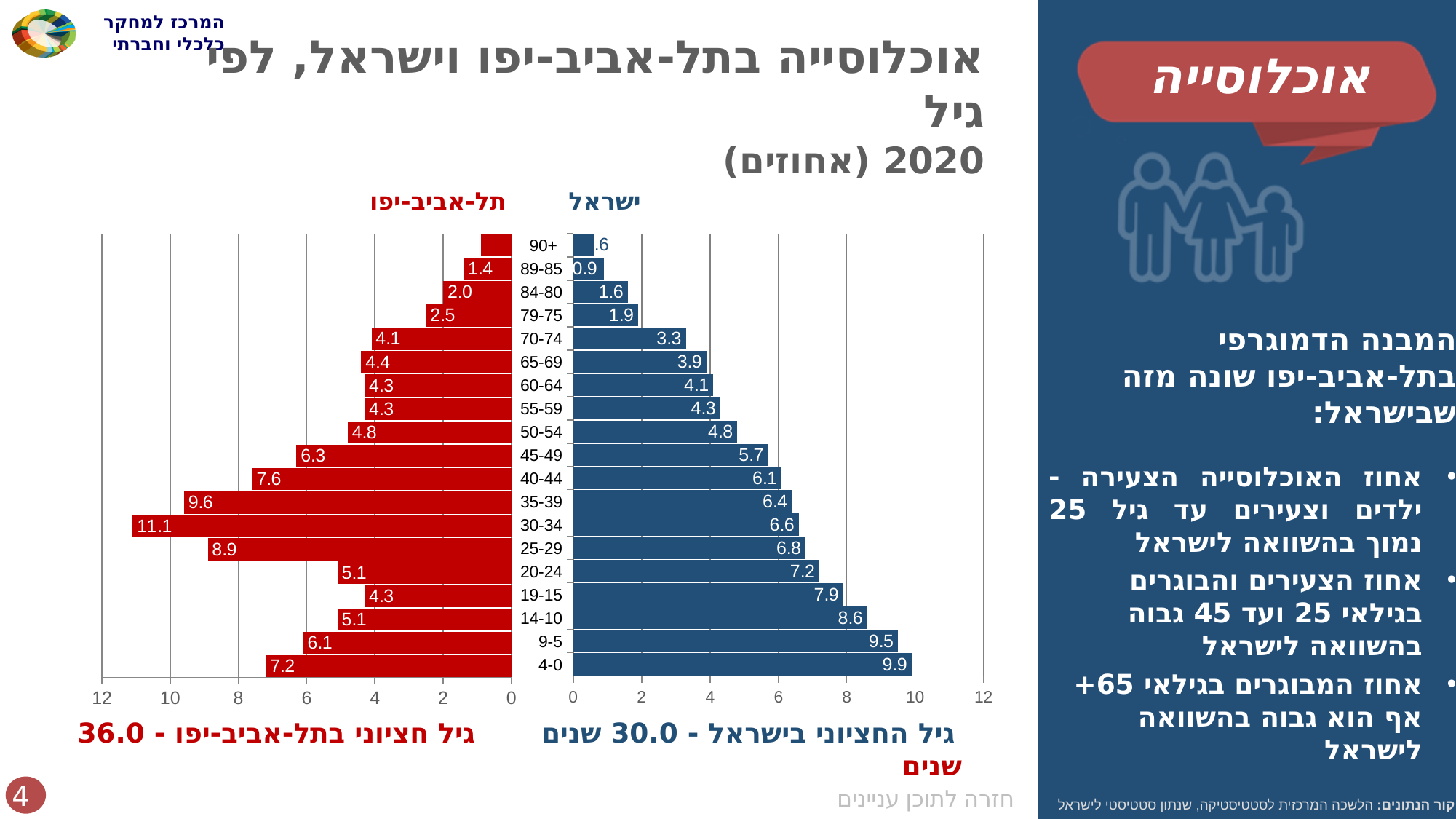
How many age groups are shown on the chart? 19 For the 0-4 age group, which is larger: the value for Israel or for Tel Aviv-Yafo? Israel What kind of chart is shown on the slide? bar chart (population pyramid) What median age is stated for Tel Aviv-Yafo below the chart? 36.0 What is the value for the 70-74 age group in Israel? 3.3 Which age group has the lowest value for Israel? 90+ What is the value for the 30-34 age group in Tel Aviv-Yafo? 11.1 Which age group has the highest value for Tel Aviv-Yafo? 30-34 What is the value for the 0-4 age group in Israel? 9.9 Is the value for the 90+ age group in Tel Aviv-Yafo greater or less than 2? less Which age group has the highest value for Israel? 0-4 What is the difference between the Tel Aviv-Yafo and Israel values for the 30-34 age group? 4.5